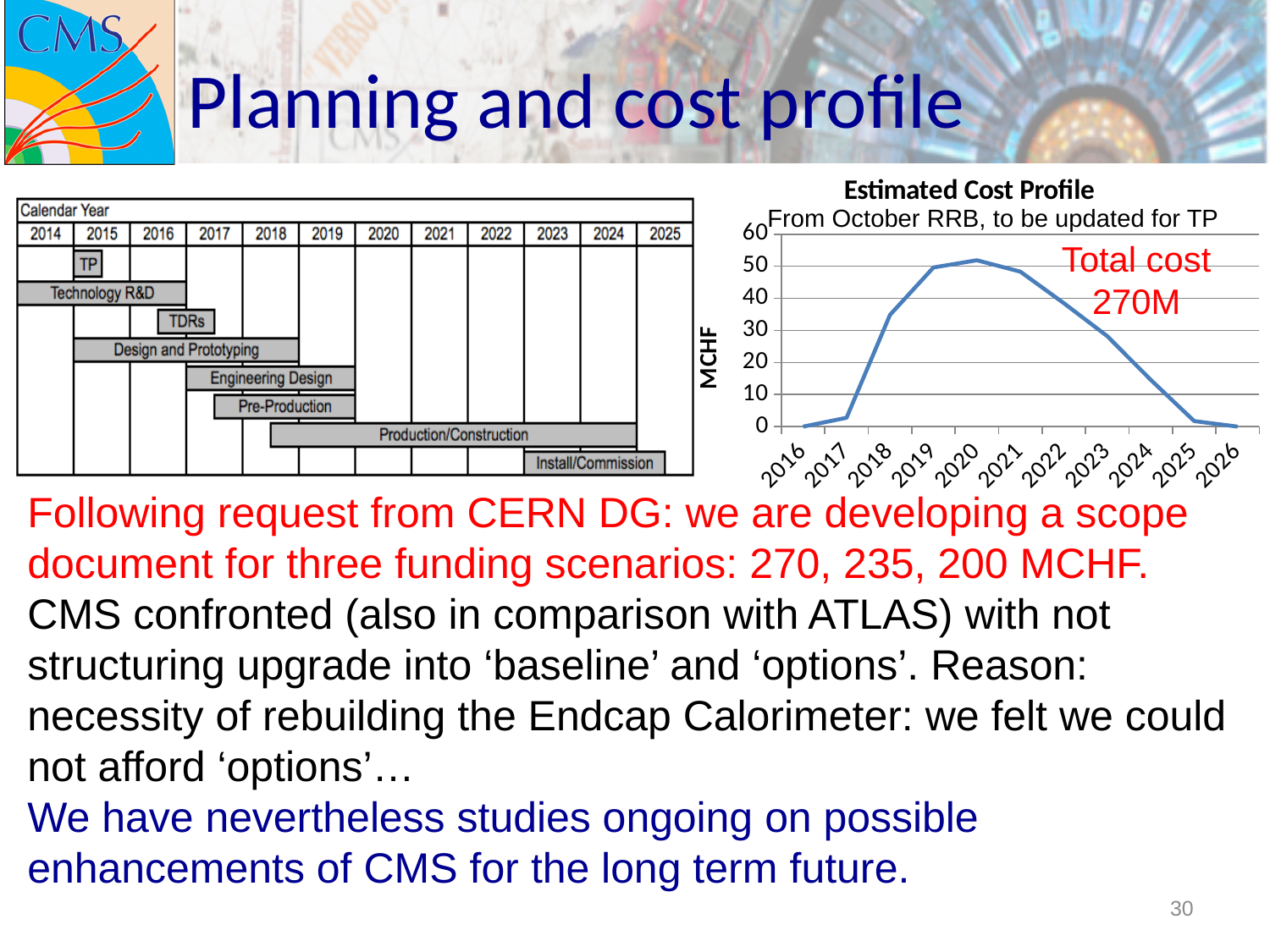
In the Estimated Cost Profile chart, is the value for 2017 greater or less than 10? less In the Estimated Cost Profile chart, is the value for 2024 greater or less than 20? less In the Estimated Cost Profile chart, do the values rise or fall from 2020 to 2025? fall What total cost is annotated on the Estimated Cost Profile chart? 270M What kind of chart is the Estimated Cost Profile? line chart In the Estimated Cost Profile chart, which year has the highest value? 2020 What unit is shown on the y axis of the Estimated Cost Profile chart? MCHF In the Estimated Cost Profile chart, which year has the larger value, 2018 or 2024? 2018 In the Estimated Cost Profile chart, is the value for 2023 greater or less than 20? greater How many years are shown on the x axis of the Estimated Cost Profile chart? 11